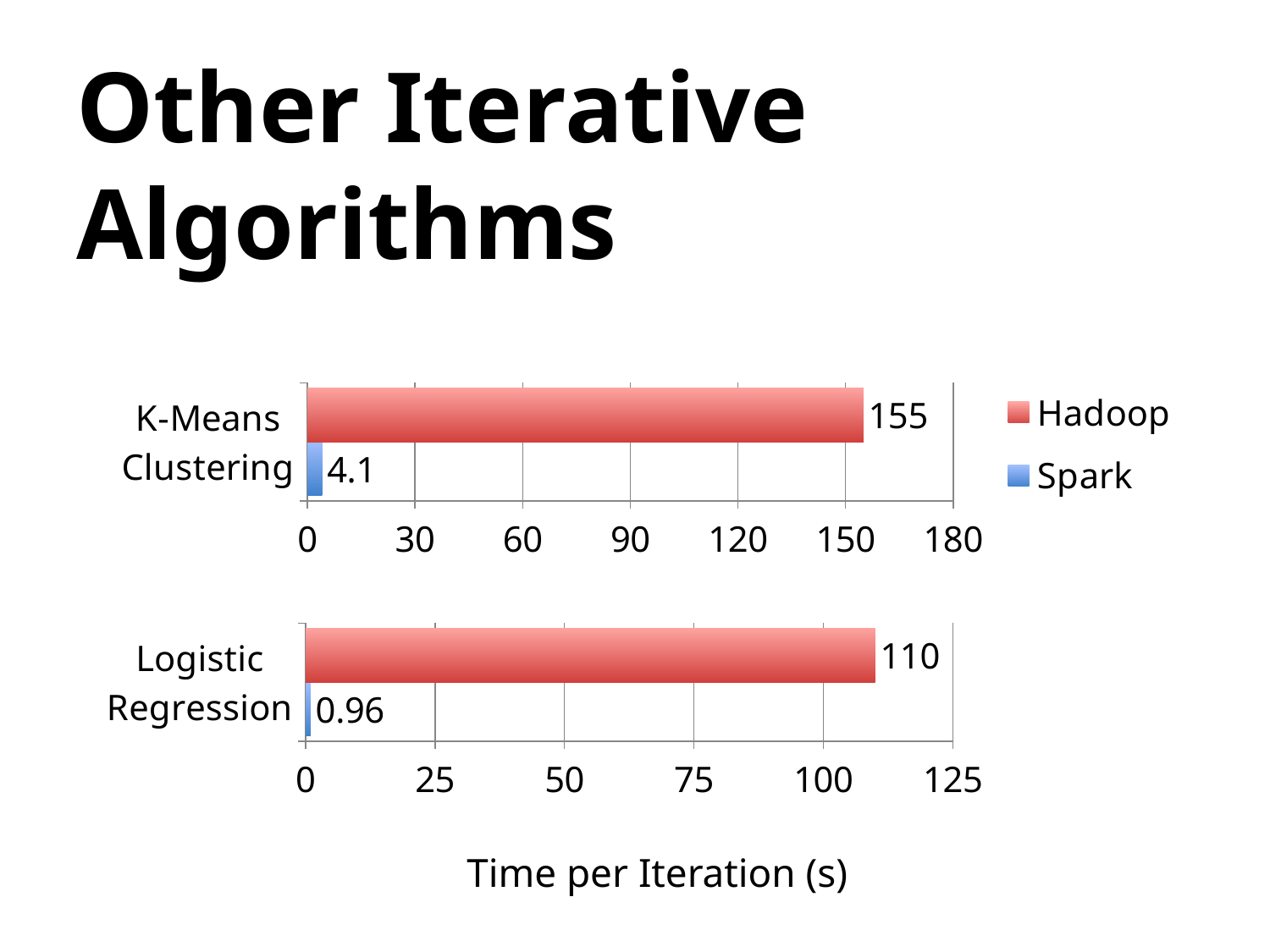
In the top chart (K-Means Clustering), is the Hadoop value greater or less than 150? greater In the top chart (K-Means Clustering), what is the time per iteration for Hadoop? 155 In the top chart (K-Means Clustering), what is the time per iteration for Spark? 4.1 In the bottom chart (Logistic Regression), what is the time per iteration for Hadoop? 110 In the top chart (K-Means Clustering), which series has the longer time per iteration, Hadoop or Spark? Hadoop What kind of chart is used on this slide? Bar chart How many series does the legend list? 2 In the bottom chart (Logistic Regression), which series has the shortest time per iteration? Spark In the bottom chart (Logistic Regression), what is the time per iteration for Spark? 0.96 In the top chart (K-Means Clustering), what is the difference between the Hadoop and Spark times per iteration? 150.9 In the bottom chart (Logistic Regression), what is the difference between the Hadoop and Spark times per iteration? 109.04 What is the x-axis label shown beneath the charts? Time per Iteration (s)